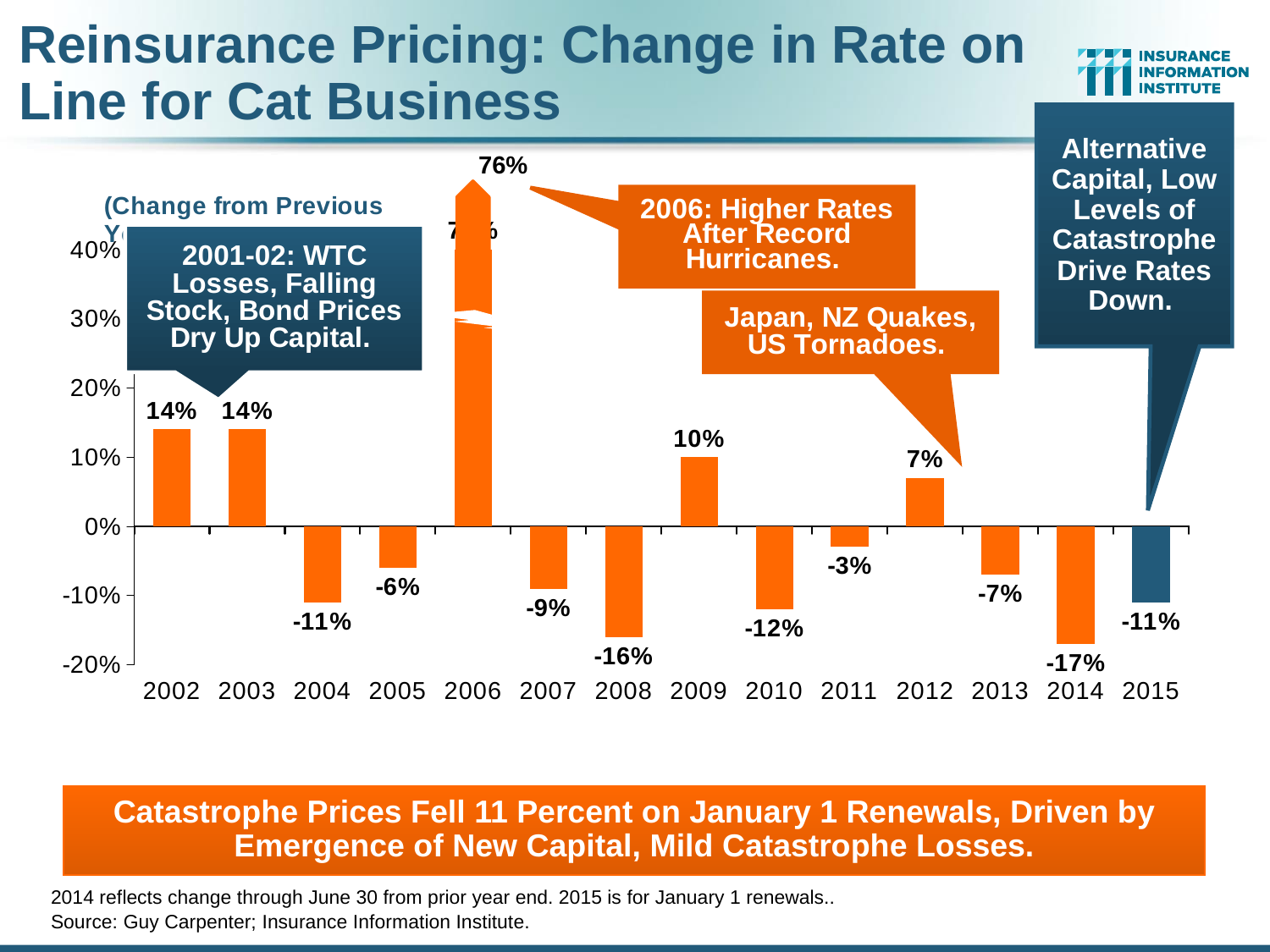
What is the change in rate on line for 2006? 76% How many years are shown on the x axis? 14 Which year has the lowest change in rate on line? 2014 Which year's bar is shown in a different colour (dark blue) from the others? 2015 Which is larger, the value for 2008 or the value for 2010? 2010 What type of chart is shown on the slide? bar chart What is the value shown for 2015? -11% What is the difference between the values for 2009 and 2012? 3% Is the value for 2004 greater or less than -10%? less What is the value shown for 2014? -17% Which year has the highest change in rate on line? 2006 What is the value shown for 2009? 10%